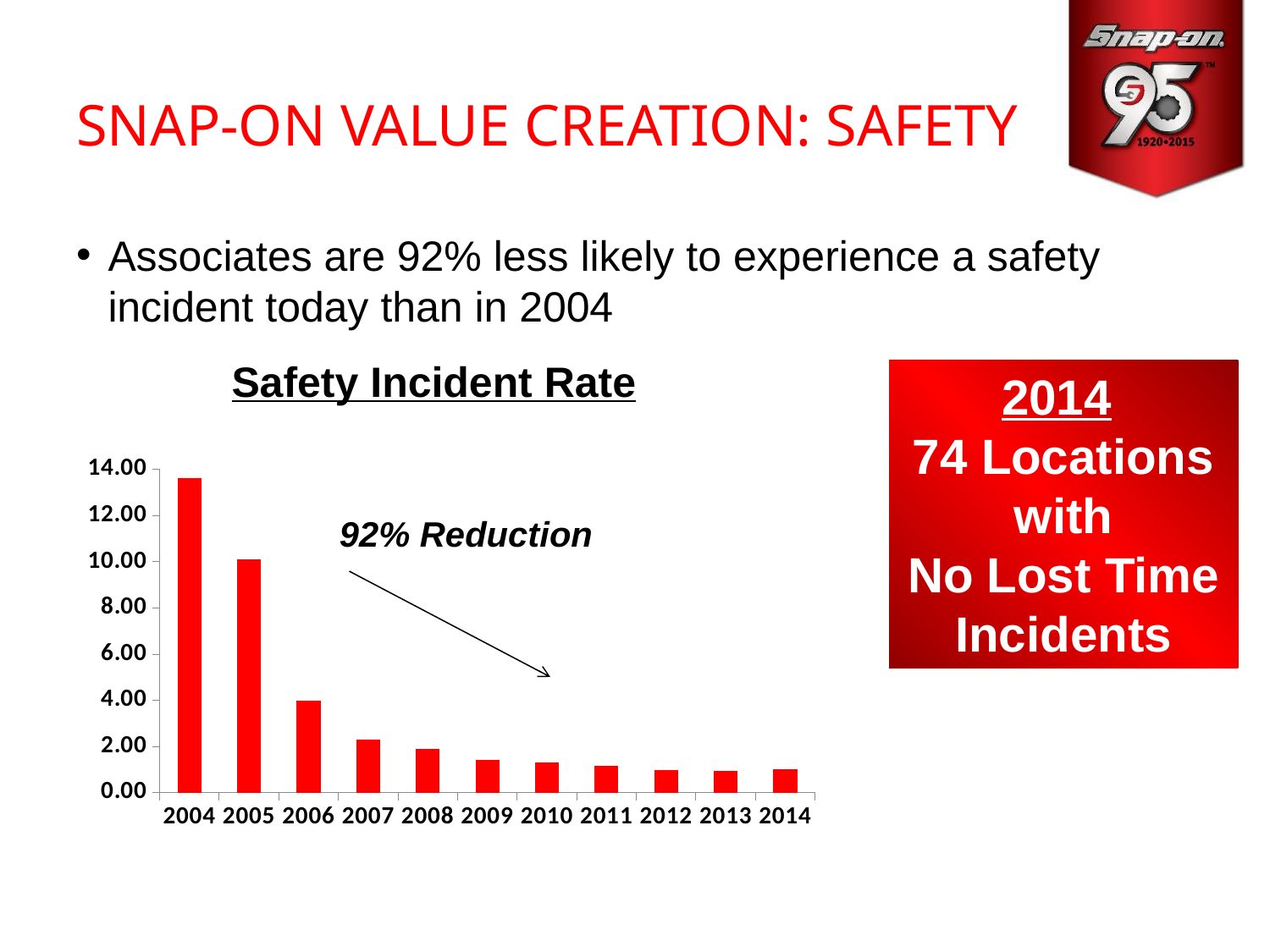
What percentage reduction is annotated on the Safety Incident Rate chart? 92% Reduction How many years are plotted on the Safety Incident Rate chart? 11 Does the safety incident rate generally rise or fall from 2004 to 2014? Fall What kind of chart is used to show the Safety Incident Rate? Bar chart Is the safety incident rate for 2014 greater or less than 2.00? less Is the safety incident rate for 2004 greater or less than 12.00? greater Which year has a higher safety incident rate, 2004 or 2005? 2004 Is the safety incident rate for 2007 greater or less than 4.00? less What is the title of the chart on the slide? Safety Incident Rate Which year has the highest safety incident rate on the chart? 2004